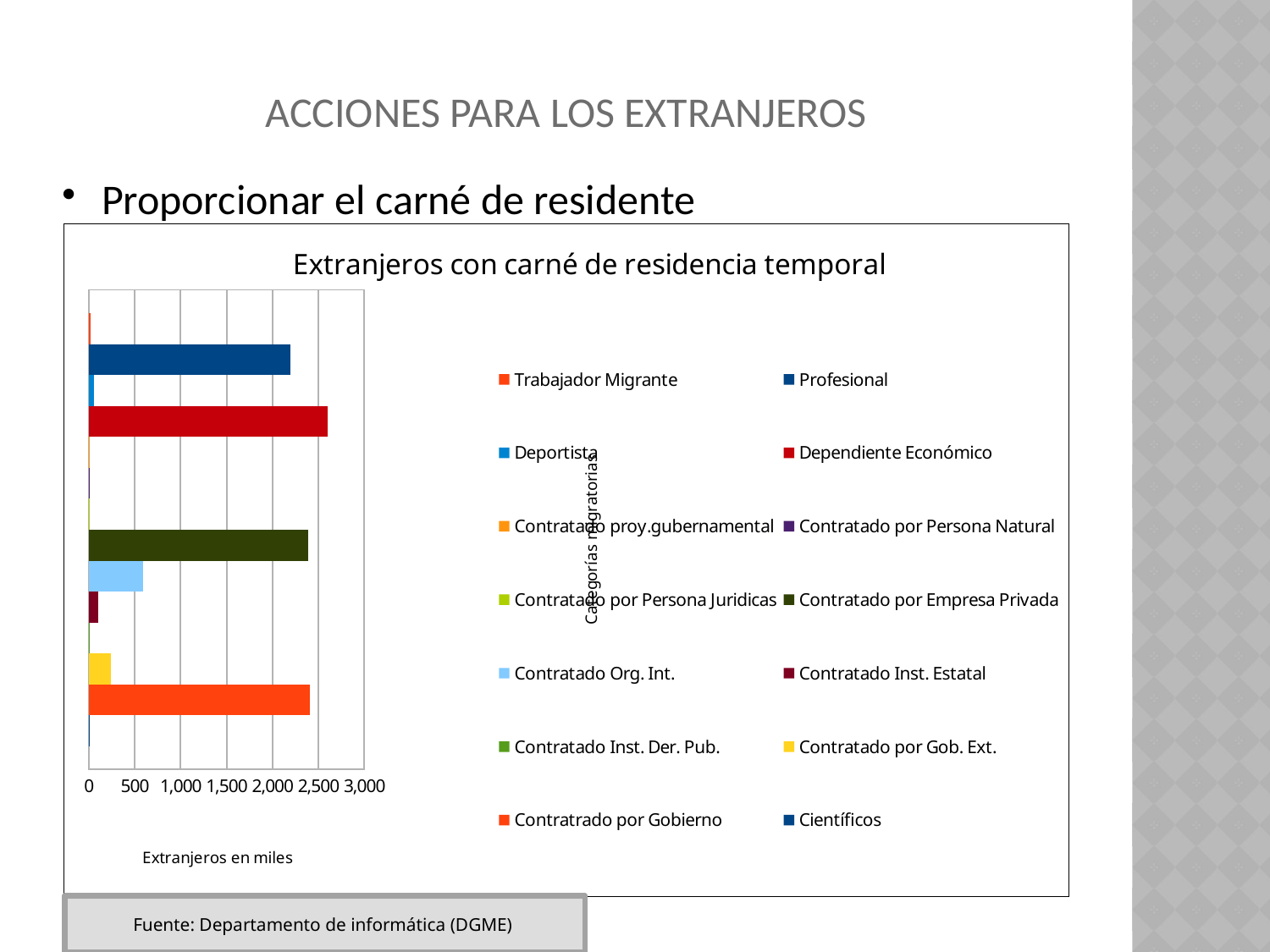
Is the value for Contratado Org. Int. greater or less than 1,000? less Which is larger, the value for Profesional or the value for Dependiente Económico? Dependiente Económico Is the value for Contratrado por Gobierno greater or less than 2,000? greater What is the title of the chart? Extranjeros con carné de residencia temporal Is the value for Contratado por Gob. Ext. greater or less than 500? less Which is larger, the value for Contratado Org. Int. or the value for Contratado por Gob. Ext.? Contratado Org. Int. What kind of chart is shown on the slide? bar chart Which category has the longest bar in the chart? Dependiente Económico What is the label on the horizontal axis of the chart? Extranjeros en miles How many series does the chart legend list? 14